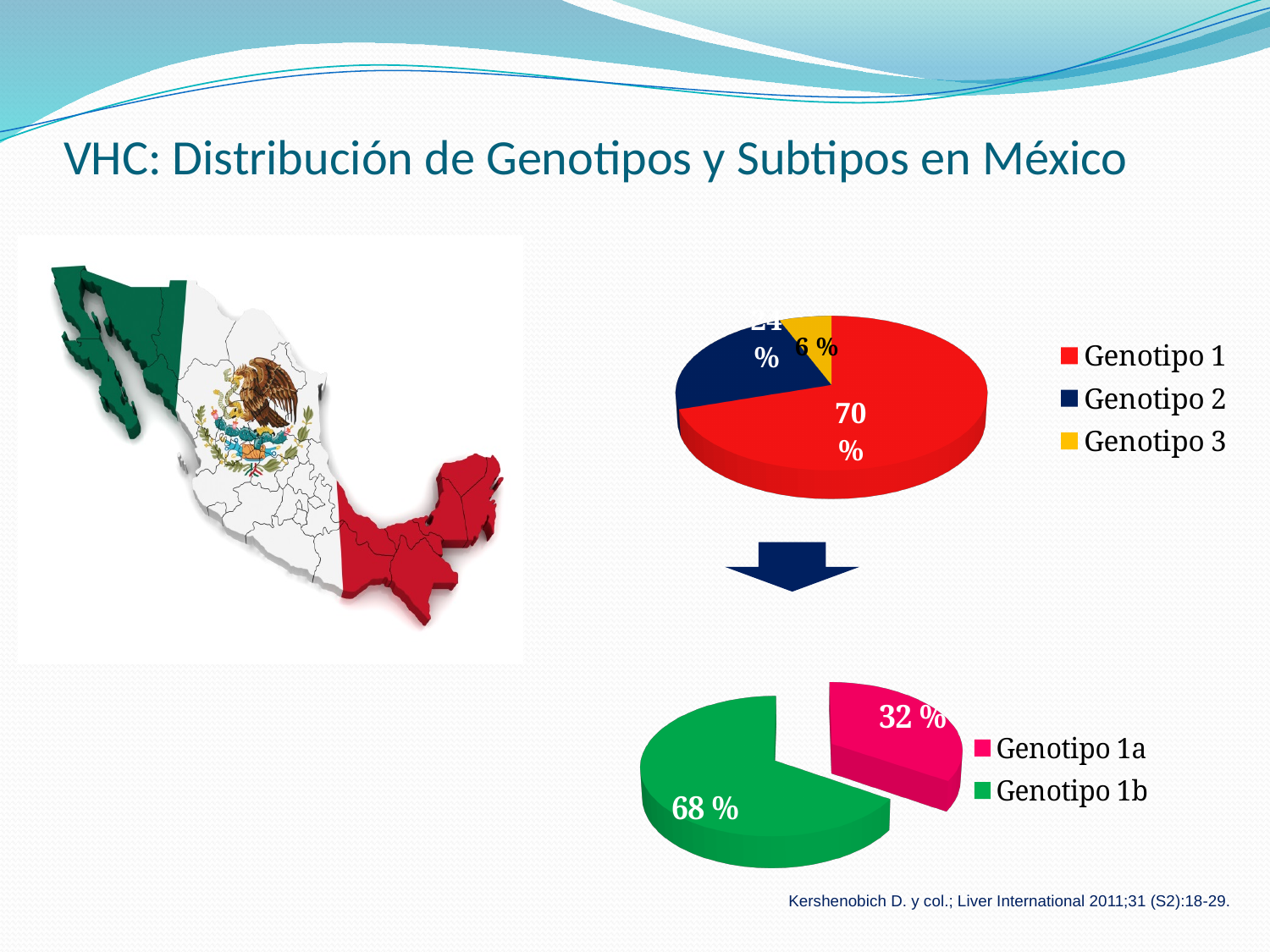
In the top pie chart, what percentage is shown for Genotipo 3? 6 % In the top pie chart, what is the difference in percentage points between Genotipo 1 and Genotipo 3? 64 % How many categories does the legend of the top pie chart list? 3 In the top pie chart, which genotype has the largest share? Genotipo 1 In the bottom pie chart, which subtype has the larger share, Genotipo 1a or Genotipo 1b? Genotipo 1b In the bottom pie chart, what percentage is shown for Genotipo 1a? 32 % In the bottom pie chart, what is the difference in percentage points between Genotipo 1b and Genotipo 1a? 36 % In the top pie chart, which genotype has the smallest share? Genotipo 3 In the bottom pie chart, what colour represents Genotipo 1b? Green What type of chart is the bottom chart on the slide? Pie chart In the bottom pie chart, what percentage is shown for Genotipo 1b? 68 % In the top pie chart, what percentage is shown for Genotipo 1? 70 %